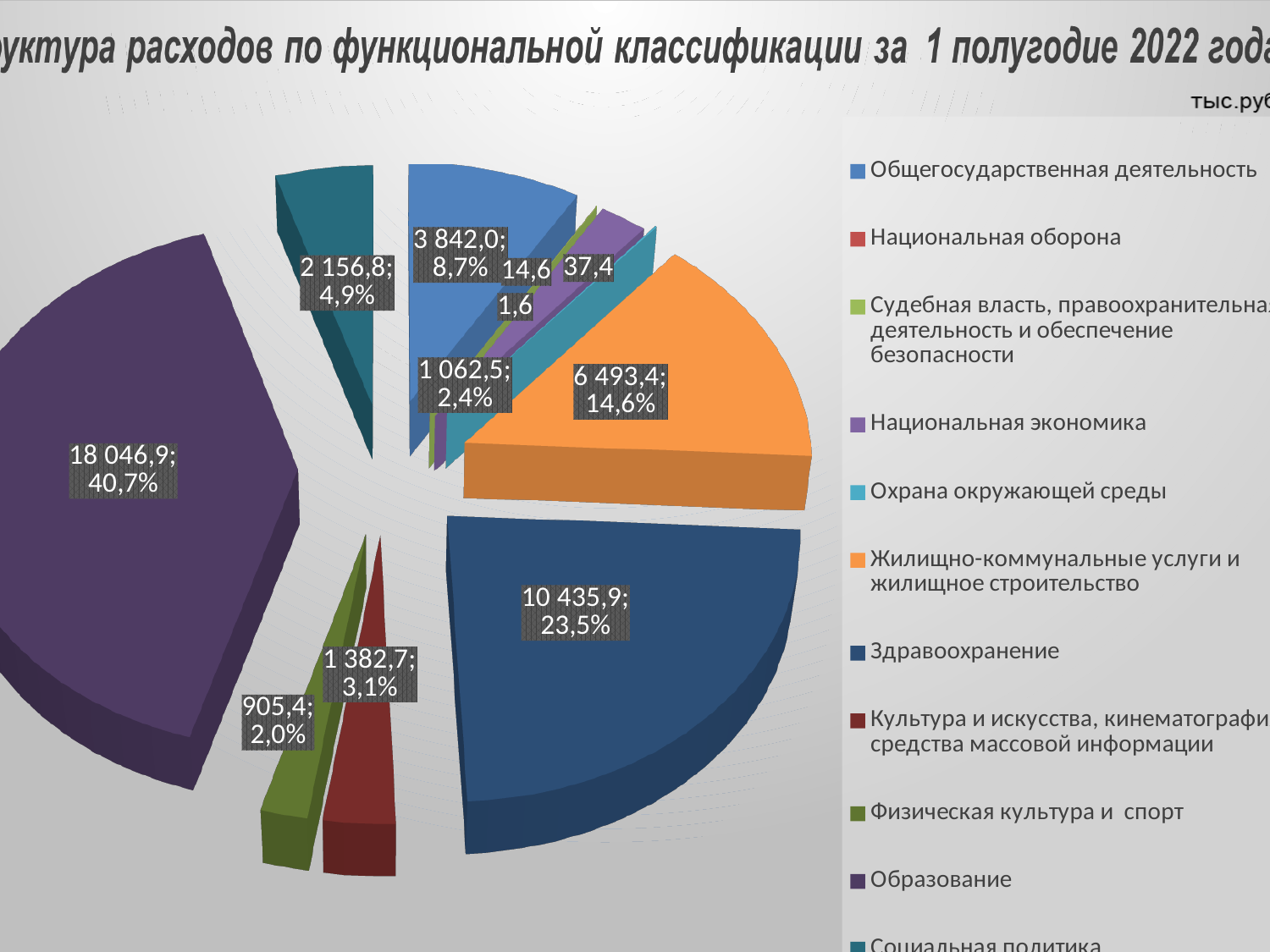
What share of the pie does Образование account for? 40,7% What value is shown for Общегосударственная деятельность? 3 842,0 What value is shown for Образование? 18 046,9 What value is shown for Здравоохранение? 10 435,9 Which is larger, Здравоохранение or Жилищно-коммунальные услуги и жилищное строительство? Здравоохранение What percentage is shown for Физическая культура и спорт? 2,0% Which category has the largest slice of the pie? Образование What kind of chart is shown on the slide? pie chart What unit of measurement is indicated on the slide for the chart values? тыс.руб. What value is shown for Социальная политика? 2 156,8 What is the difference between the values for Образование and Здравоохранение? 7 611,0 What percentage is shown for Жилищно-коммунальные услуги и жилищное строительство? 14,6%